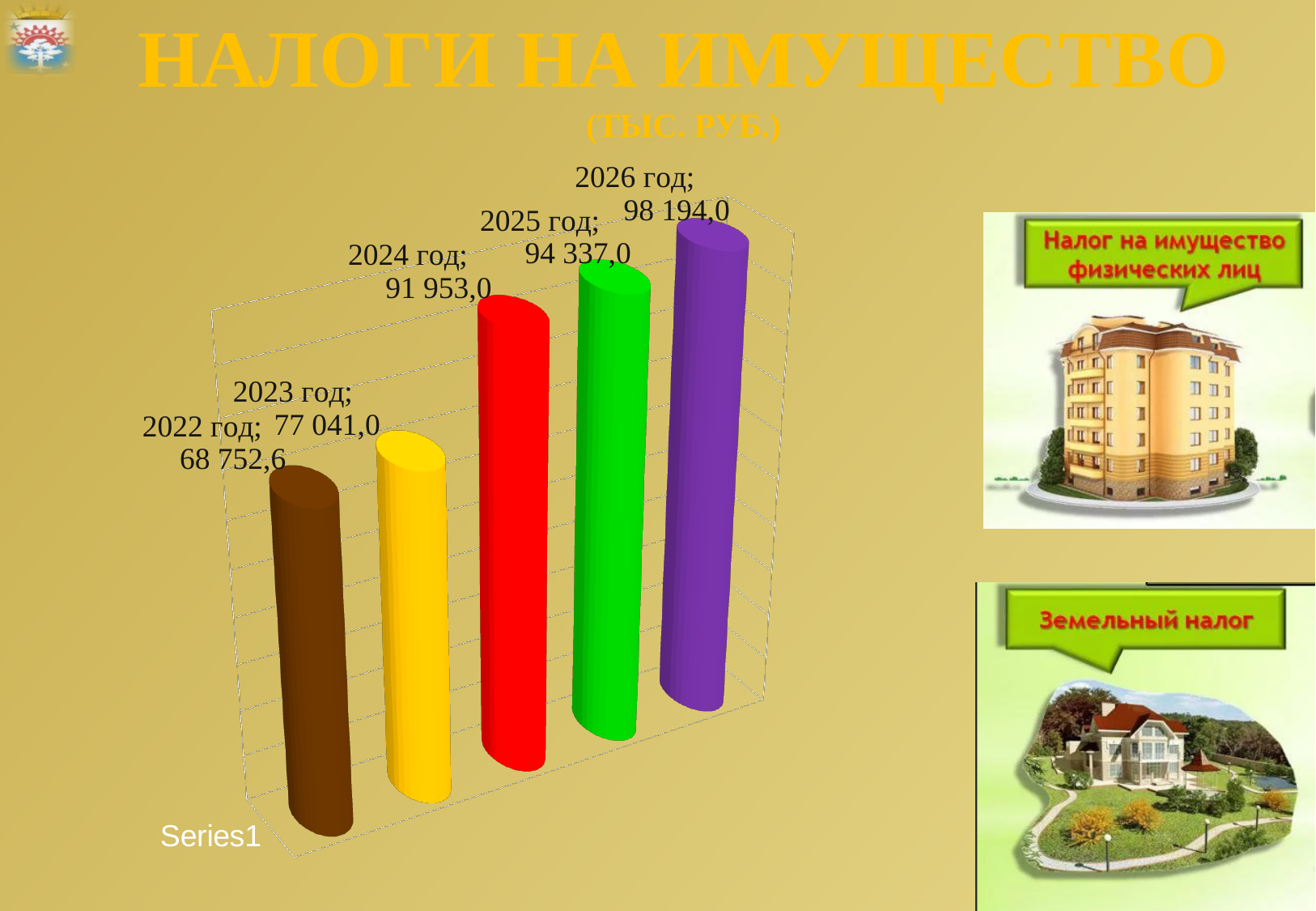
What is the difference between the values for 2024 год and 2023 год? 14 912,0 What is the value for 2024 год? 91 953,0 Which year has the highest value? 2026 год How many years (bars) are shown in the chart? 5 Do the values rise or fall from 2022 год to 2026 год? Rise What is the title of the chart? НАЛОГИ НА ИМУЩЕСТВО (ТЫС. РУБ.) What is the value for 2026 год? 98 194,0 What kind of chart is shown on the slide? Bar chart Which year has the lowest value? 2022 год What is the difference between the values for 2026 год and 2022 год? 29 441,4 Which is larger, the value for 2025 год or the value for 2024 год? 2025 год What is the value for 2022 год? 68 752,6